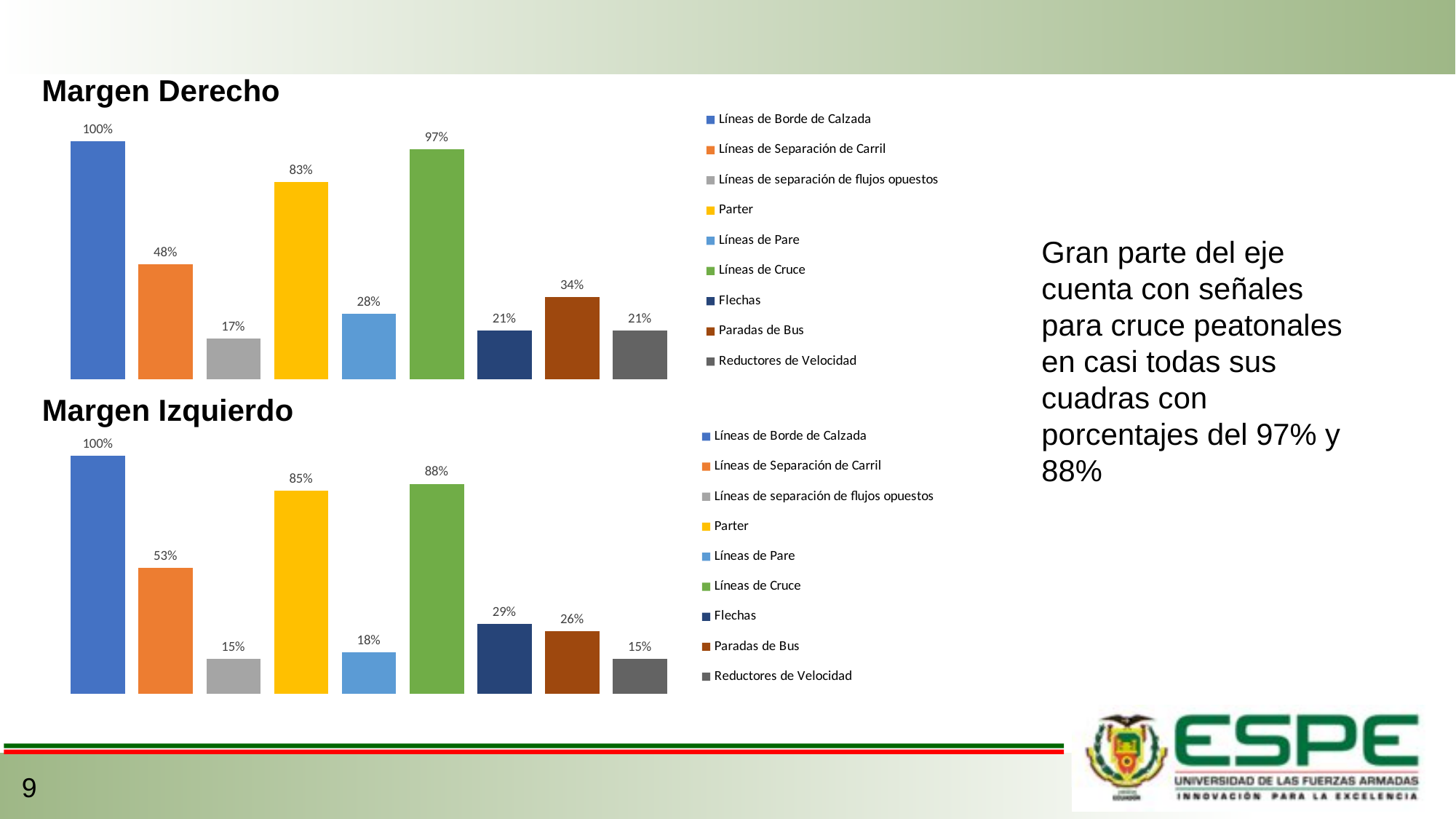
In the Margen Izquierdo chart, what is the value for Parter? 85% In the Margen Izquierdo chart, which category has the lowest value? Líneas de separación de flujos opuestos and Reductores de Velocidad (both 15%) In the Margen Derecho chart, what is the difference between Parter and Líneas de Separación de Carril? 35% What kind of chart is the Margen Izquierdo chart? Bar chart In the Margen Derecho chart, which category has the highest value? Líneas de Borde de Calzada In the Margen Izquierdo chart, what is the difference between Líneas de Separación de Carril and Líneas de Pare? 35% How many series does the legend of the Margen Derecho chart list? 9 In the Margen Izquierdo chart, which is larger: Líneas de Cruce or Parter? Líneas de Cruce In the Margen Derecho chart, what is the value for Líneas de Cruce? 97% In the Margen Izquierdo chart, what is the value for Flechas? 29% In the Margen Derecho chart, what is the value for Paradas de Bus? 34% In the Margen Derecho chart, what colour is the bar for Líneas de Cruce? Green